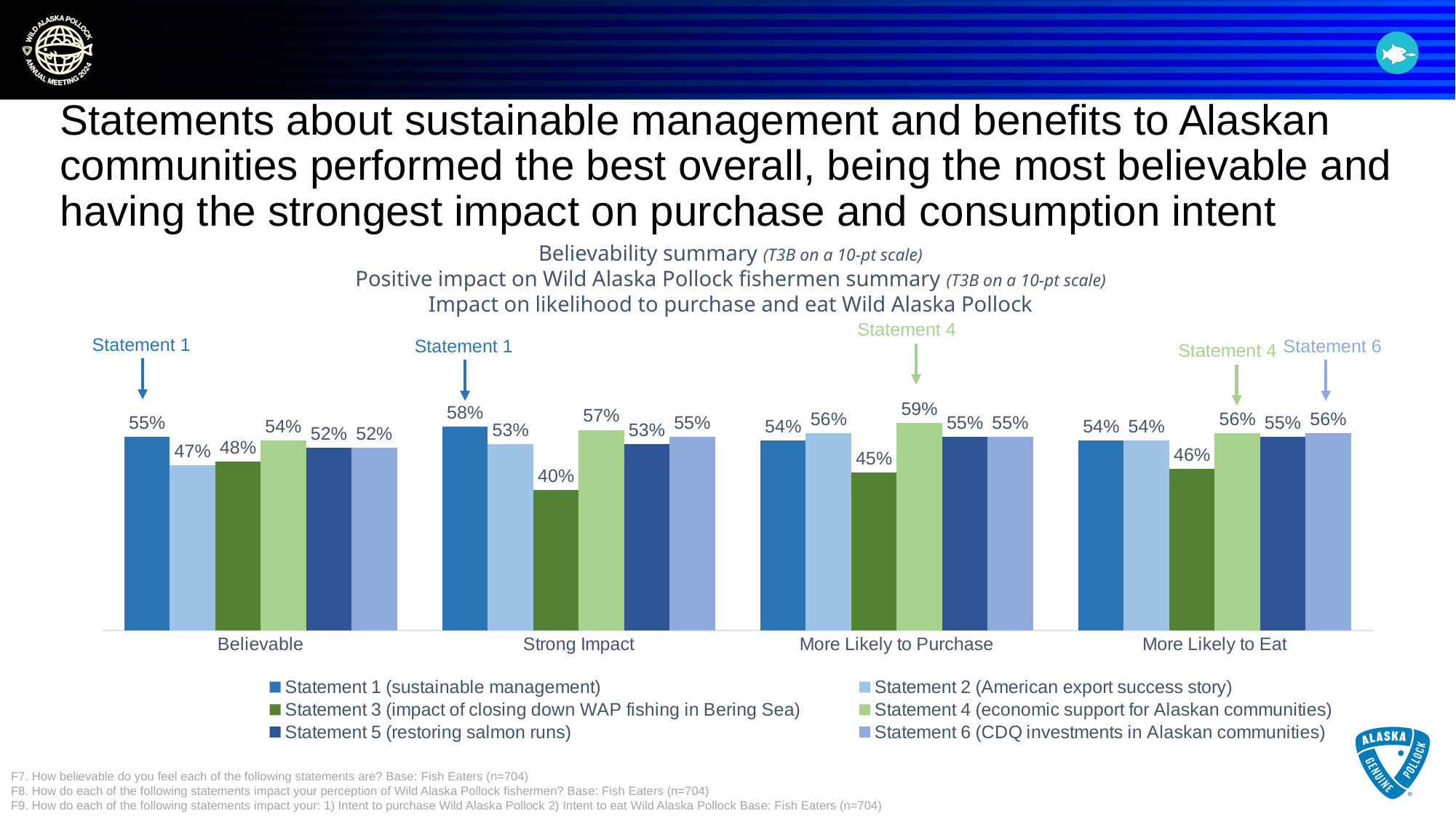
What kind of chart is shown on the slide? Bar chart What is the value for Statement 2 (American export success story) in the More Likely to Eat category? 54% What is the value for Statement 1 (sustainable management) in the Believable category? 55% What is the value for Statement 4 (economic support for Alaskan communities) in the More Likely to Purchase category? 59% Which statement has the lowest value in the Believable category? Statement 2 (American export success story) Which statement has the highest value in the Strong Impact category? Statement 1 (sustainable management) How many series does the legend list? 6 What is the value for Statement 3 (impact of closing down WAP fishing in Bering Sea) in the Strong Impact category? 40% How many categories are shown on the x axis? 4 What is the difference between Statement 4 and Statement 3 in the More Likely to Purchase category? 14 percentage points Which statement does the legend describe as 'restoring salmon runs'? Statement 5 In the Strong Impact category, which is larger: Statement 4 or Statement 6? Statement 4